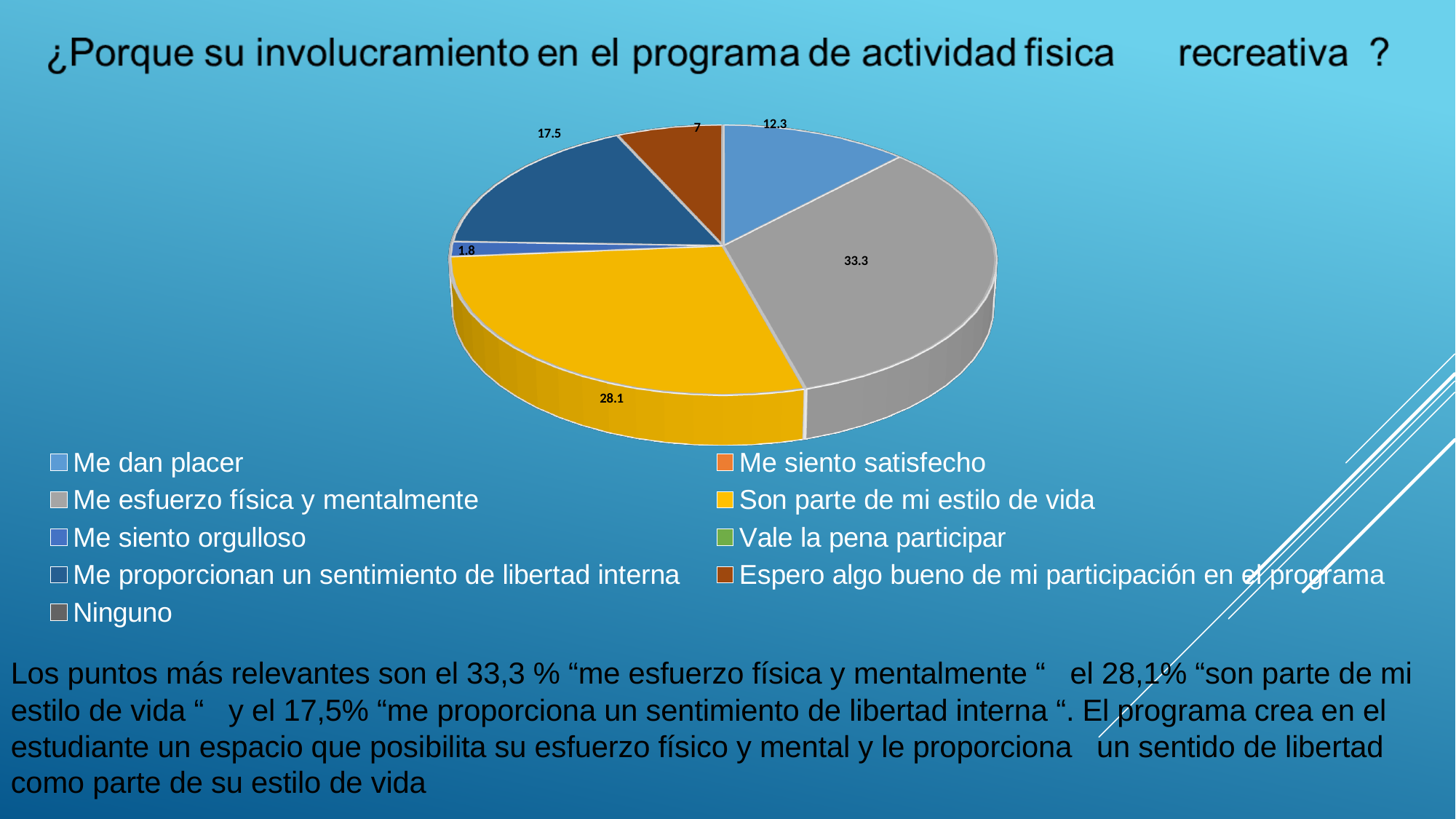
What value is shown for the slice "Me esfuerzo física y mentalmente"? 33.3 What colour is the slice for "Son parte de mi estilo de vida"? Yellow What value is shown for the slice "Son parte de mi estilo de vida"? 28.1 What kind of chart is shown on the slide? Pie chart Which is larger, the value for "Me dan placer" or the value for "Me proporcionan un sentimiento de libertad interna"? Me proporcionan un sentimiento de libertad interna What is the difference between the values for "Me esfuerzo física y mentalmente" and "Son parte de mi estilo de vida"? 5.2 Which labelled slice has the smallest value? Me siento orgulloso What value is shown for the slice "Me proporcionan un sentimiento de libertad interna"? 17.5 Which category has the largest slice of the pie? Me esfuerzo física y mentalmente What value is shown for the slice "Me dan placer"? 12.3 How many entries does the legend list? 9 What value is shown for the slice "Espero algo bueno de mi participación en el programa"? 7